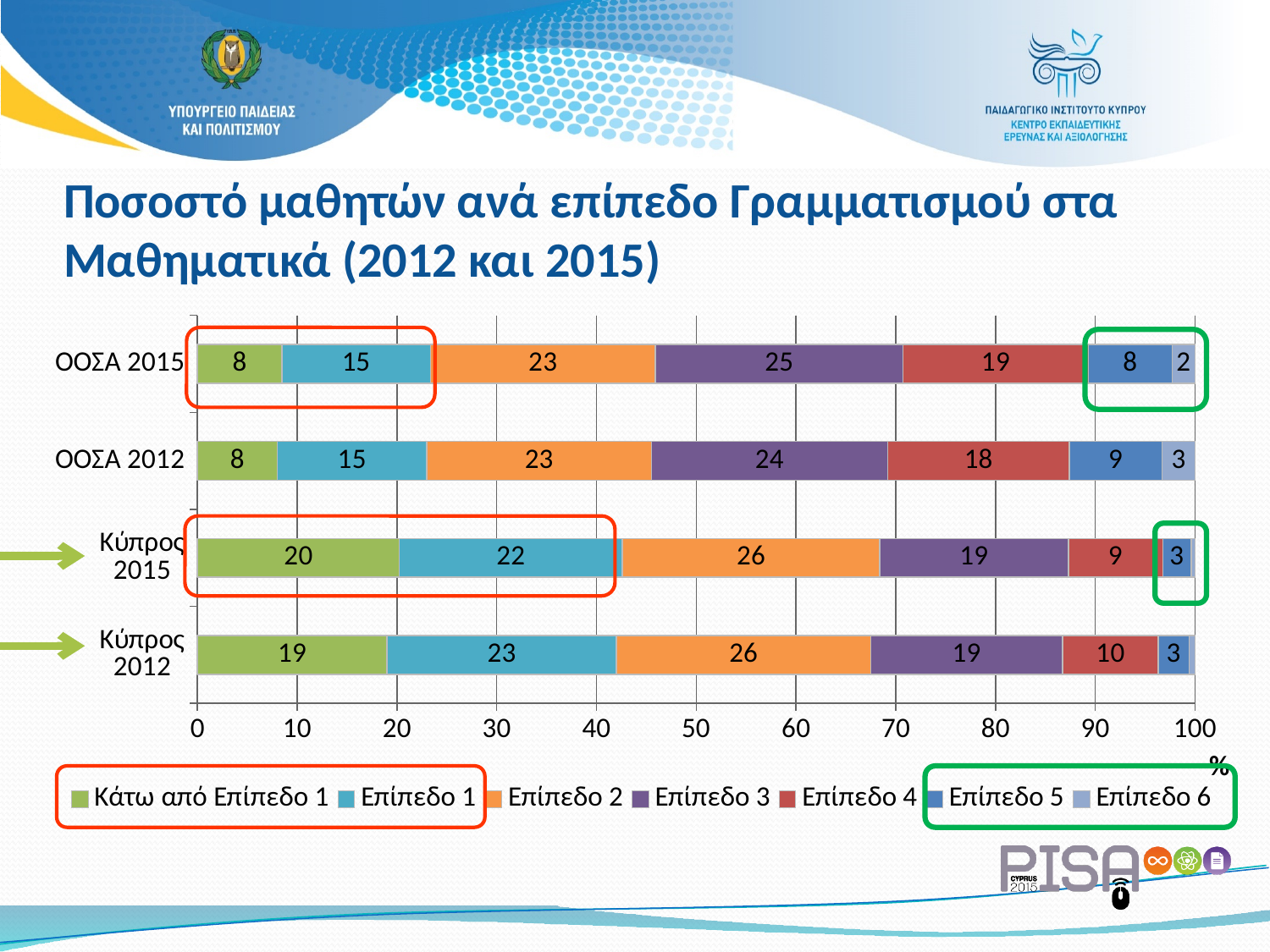
Which has the larger Επίπεδο 2 value, Κύπρος 2015 or ΟΟΣΑ 2015? Κύπρος 2015 What is the value for Επίπεδο 3 in the ΟΟΣΑ 2015 bar? 25 Which bar has the highest Επίπεδο 1 value? Κύπρος 2012 What is the value for Επίπεδο 6 in the ΟΟΣΑ 2012 bar? 3 Which bar has the highest Επίπεδο 3 value? ΟΟΣΑ 2015 What kind of chart is shown on the slide? Stacked bar chart What is the difference between the Κάτω από Επίπεδο 1 values for Κύπρος 2015 and ΟΟΣΑ 2015? 12 What is the difference between the Επίπεδο 4 values for ΟΟΣΑ 2015 and Κύπρος 2015? 10 What is the value for Επίπεδο 4 in the Κύπρος 2012 bar? 10 How many bars (categories) are shown in the chart? 4 What is the value for Κάτω από Επίπεδο 1 in the Κύπρος 2015 bar? 20 How many series does the legend list? 7